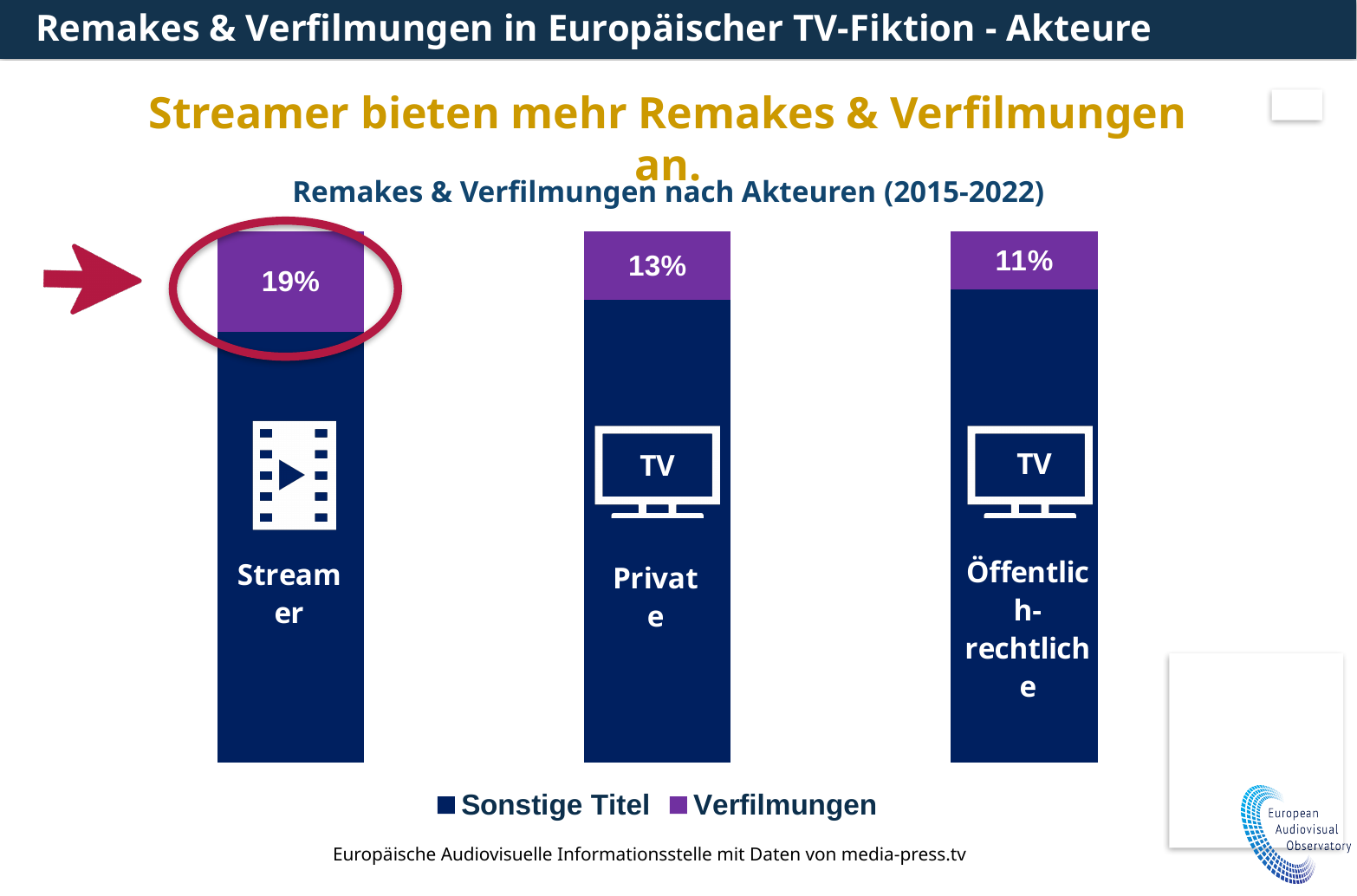
What is the Verfilmungen share for Öffentlich-rechtliche? 11% How many categories (actor types) are shown in the chart? 3 What is the difference in Verfilmungen share between Streamer and Private? 6 percentage points Which category has the highest Verfilmungen share? Streamer What is the Verfilmungen share for Private? 13% What is the Verfilmungen share for Streamer? 19% Which category has the lowest Verfilmungen share? Öffentlich-rechtliche What is the difference in Verfilmungen share between Streamer and Öffentlich-rechtliche? 8 percentage points How many series does the legend list? 2 What is the title of the chart? Remakes & Verfilmungen nach Akteuren (2015-2022) Which has a larger Verfilmungen share, Private or Öffentlich-rechtliche? Private What kind of chart is shown on the slide? Stacked bar chart